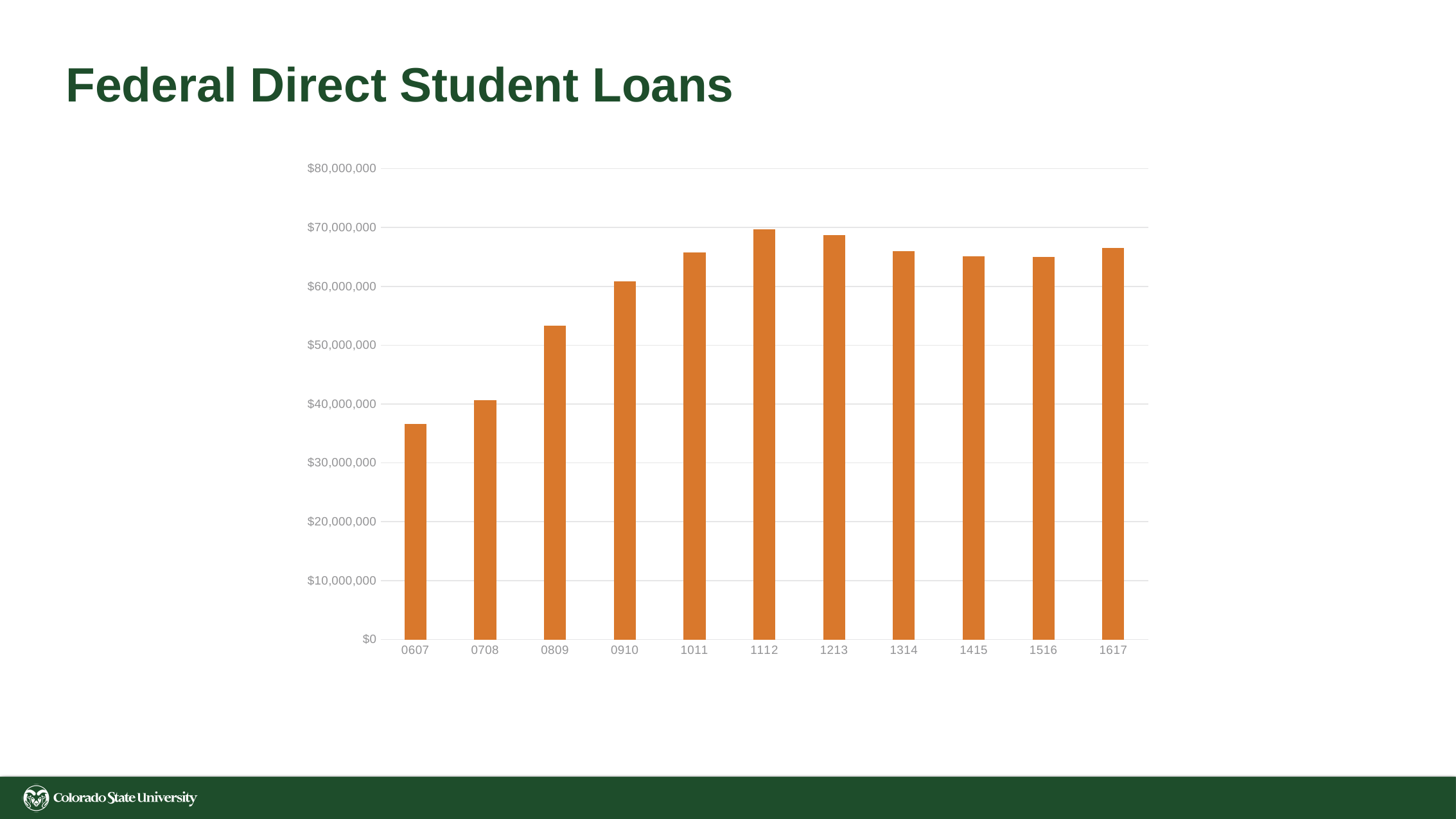
Is the value for 0809 greater or less than $50,000,000? greater What kind of chart is shown on the slide? bar chart Do the values rise or fall from 0607 to 1112? rise Which is larger, the value for 0607 or the value for 1617? 1617 Which is larger, the value for 0809 or the value for 0910? 0910 Which year has the highest value? 1112 Is the value for 0910 greater or less than $60,000,000? greater Is the value for 0607 greater or less than $40,000,000? less What is the title of the chart? Federal Direct Student Loans How many academic years are plotted on the x axis? 11 Which year has the lowest value? 0607